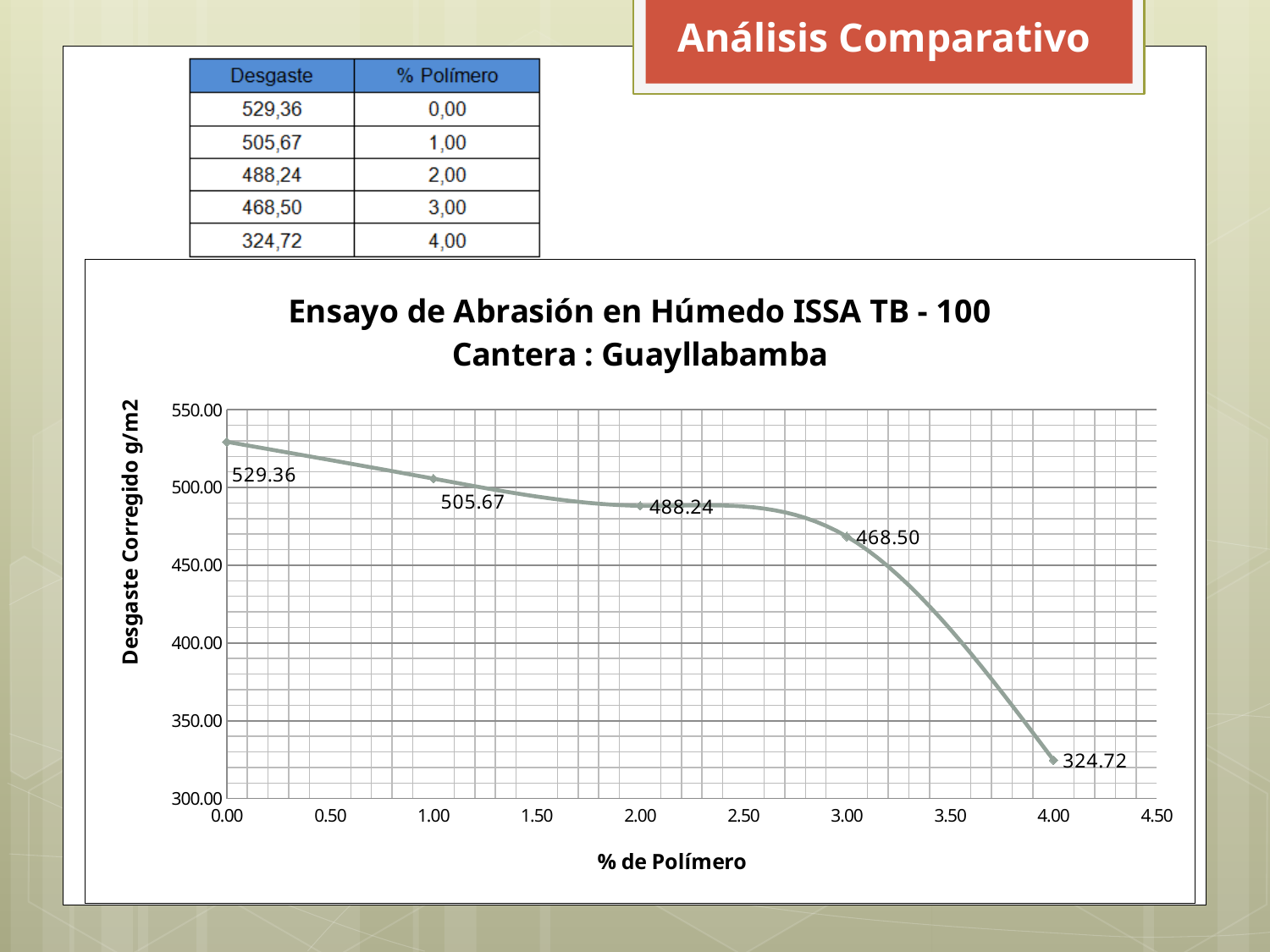
What kind of chart is shown on the slide? line chart At which % de Polímero is the Desgaste Corregido lowest? 4.00 What is the Desgaste Corregido value at 0.00 % de Polímero? 529.36 What is the Desgaste Corregido value at 2.00 % de Polímero? 488.24 How many data points are plotted on the chart? 5 What is the Desgaste Corregido value at 4.00 % de Polímero? 324.72 What is the difference between the Desgaste Corregido at 3.00 and at 4.00 % de Polímero? 143.78 What is the difference between the Desgaste Corregido at 0.00 and at 1.00 % de Polímero? 23.69 Which is larger, the Desgaste Corregido at 1.00 or at 3.00 % de Polímero? 1.00 Is the Desgaste Corregido at 3.00 % de Polímero greater or less than 450.00? greater Does the Desgaste Corregido rise or fall as % de Polímero increases? fall At which % de Polímero is the Desgaste Corregido highest? 0.00